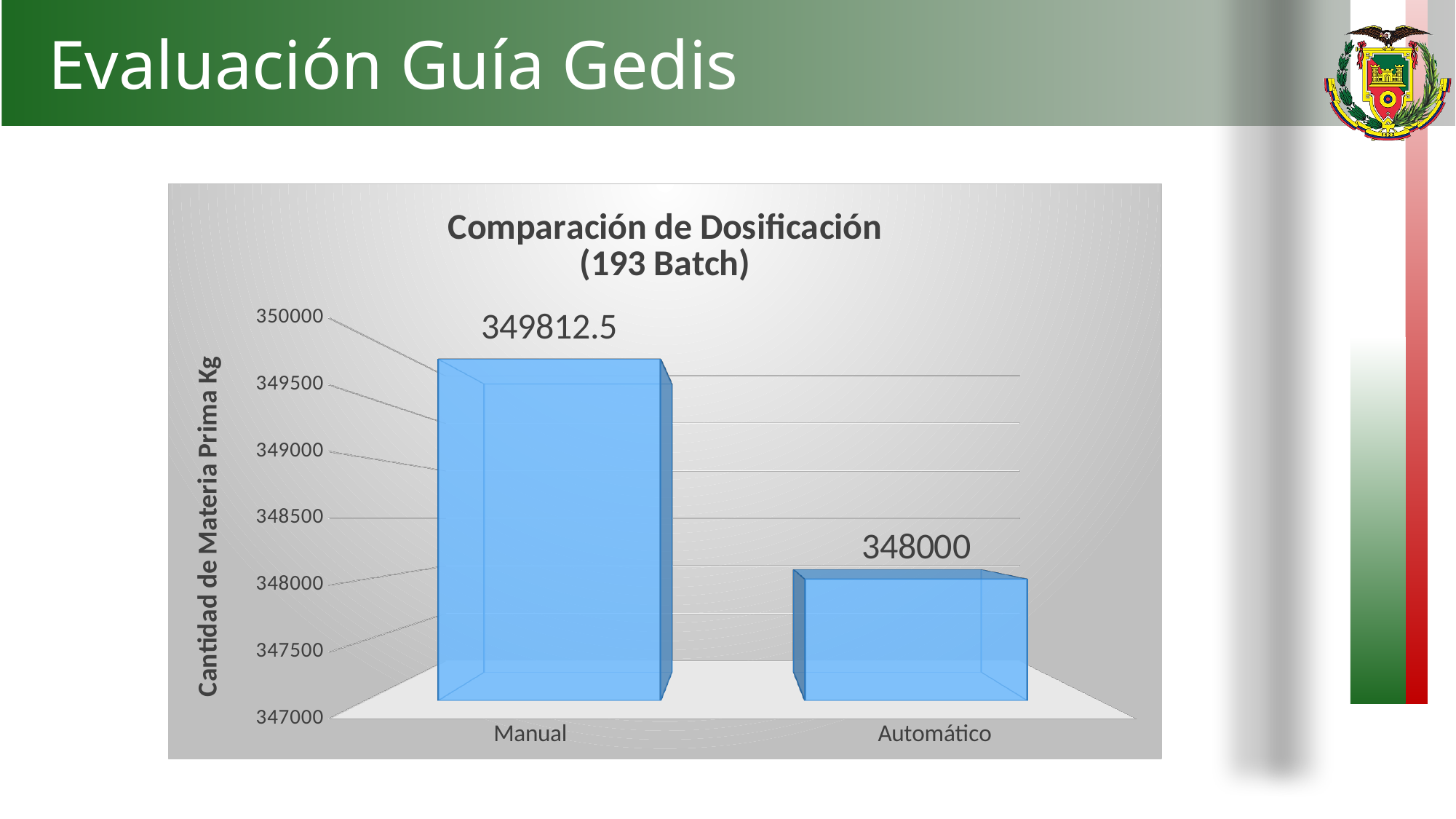
Is the value for Manual greater or less than 349500? greater What is the difference between the Manual and Automático values? 1812.5 Which is larger, the value for Manual or the value for Automático? Manual How many categories are shown on the x axis? 2 What is the value for Manual? 349812.5 What is the label of the vertical axis? Cantidad de Materia Prima Kg What kind of chart is shown? bar chart What is the value for Automático? 348000 Which category has the highest value? Manual What is the title of the chart? Comparación de Dosificación (193 Batch) Is the value for Automático greater or less than 348500? less Which category has the lowest value? Automático